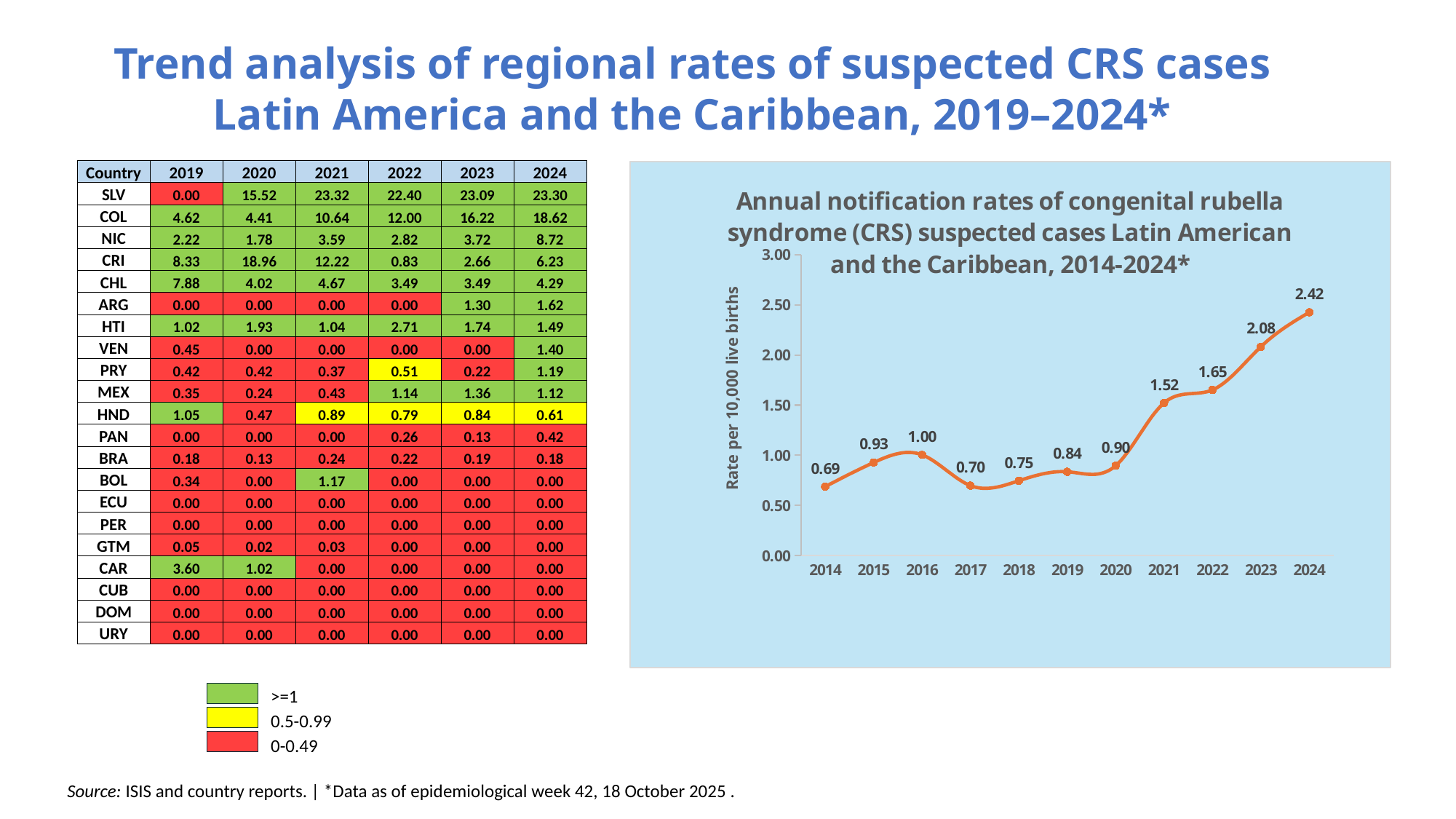
What is the label of the y axis of the line chart? Rate per 10,000 live births In the line chart, what is the difference between the rates for 2024 and 2023? 0.34 In the line chart, which year has the highest rate? 2024 In the line chart, which year has the lowest rate? 2014 In the line chart, do the rates rise or fall from 2020 to 2024? rise In the line chart, what is the rate per 10,000 live births for 2017? 0.70 In the line chart, what is the rate per 10,000 live births for 2024? 2.42 In the line chart, what is the rate per 10,000 live births for 2021? 1.52 How many years are plotted on the x axis of the line chart? 11 What type of chart is shown on the right side of the slide? line chart In the line chart, is the value for 2022 greater or less than 1.50? greater In the line chart, which year has a higher rate, 2016 or 2020? 2016